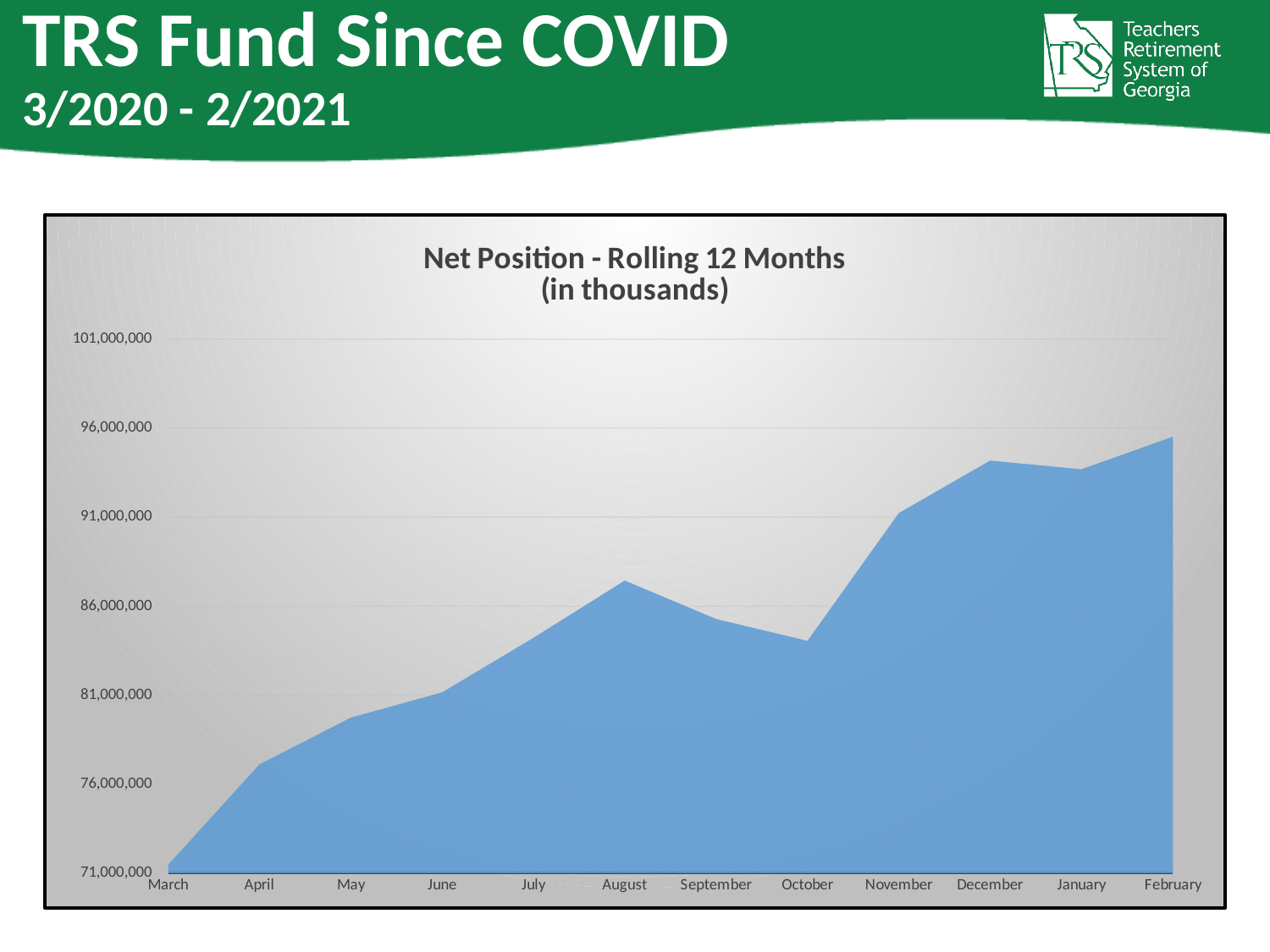
Is the value for August greater or less than 86,000,000? greater Which month has the highest net position? February What is the title of the chart? Net Position - Rolling 12 Months (in thousands) Overall, does the net position rise or fall from March to February? rise Which is larger, the value for August or the value for October? August How many months are plotted along the x axis? 12 Which month has the lowest net position? March Is the value for April greater or less than 76,000,000? greater Is the value for December greater or less than 91,000,000? greater What kind of chart is shown on the slide? area chart